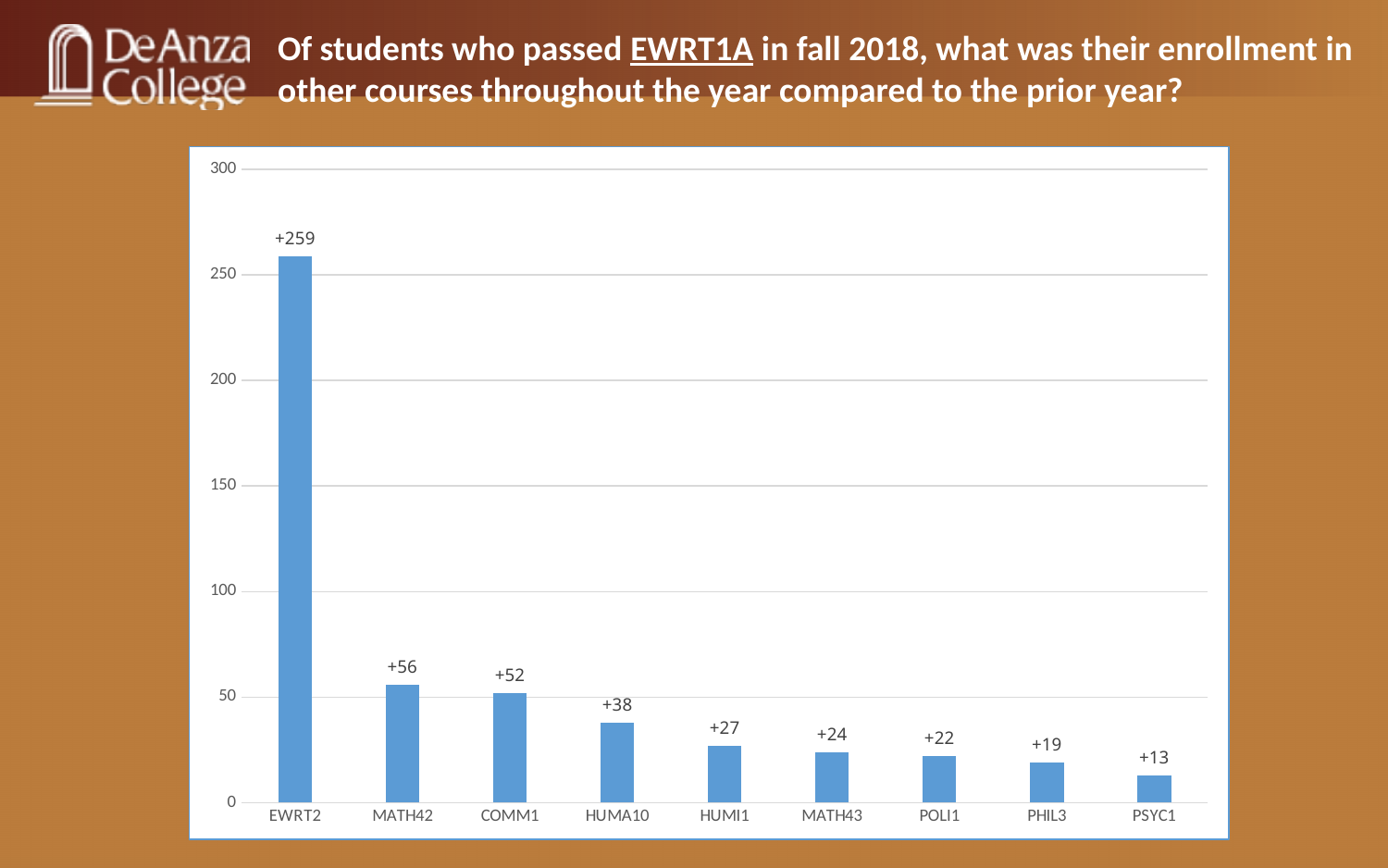
What is the value shown for HUMA10? +38 What is the value shown for PSYC1? +13 Is the value for EWRT2 greater or less than 250? greater How many courses are shown on the x axis? 9 What is the difference between the values for EWRT2 and MATH42? 203 Which course has the lowest value? PSYC1 Do the values rise or fall moving left to right along the x axis? fall What is the difference between the values for MATH42 and COMM1? 4 Which has a larger value, HUMI1 or MATH43? HUMI1 What kind of chart is shown on the slide? bar chart Which course has the highest value? EWRT2 What is the value shown for EWRT2? +259